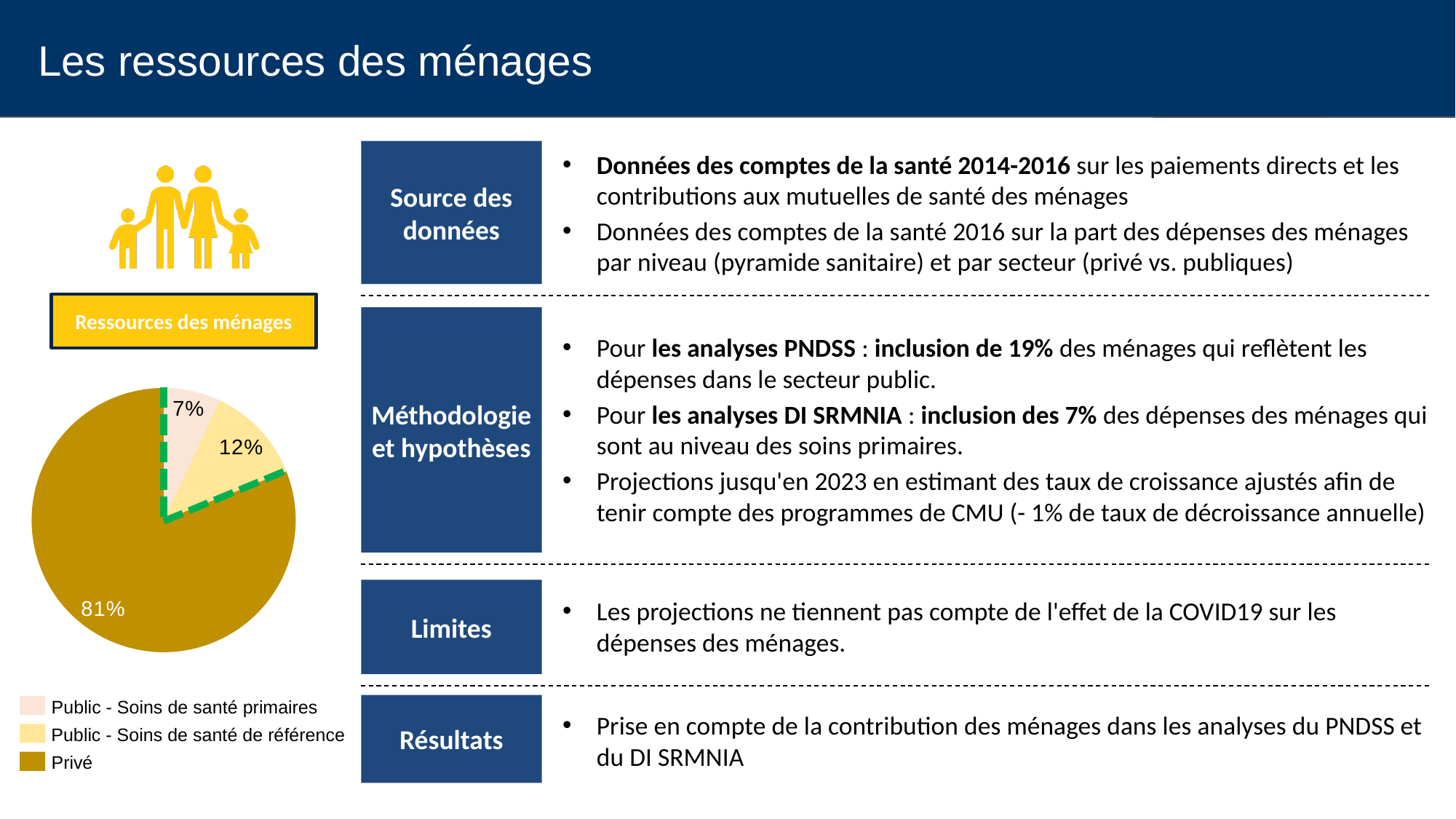
What share of the pie does Privé represent? 81% Which colour represents Privé in the pie chart legend? dark gold How many slices does the pie chart have? 3 What is the combined share of the two Public slices? 19% What kind of chart is shown on the slide? pie chart What is the difference between the Public - Soins de santé de référence share and the Public - Soins de santé primaires share? 5% What share of the pie does Public - Soins de santé de référence represent? 12% What is the difference between the Privé share and the Public - Soins de santé de référence share? 69% Which is larger: the share for Public - Soins de santé de référence or the share for Public - Soins de santé primaires? Public - Soins de santé de référence Which slice of the pie chart is the largest? Privé Which slice of the pie chart is the smallest? Public - Soins de santé primaires What share of the pie does Public - Soins de santé primaires represent? 7%